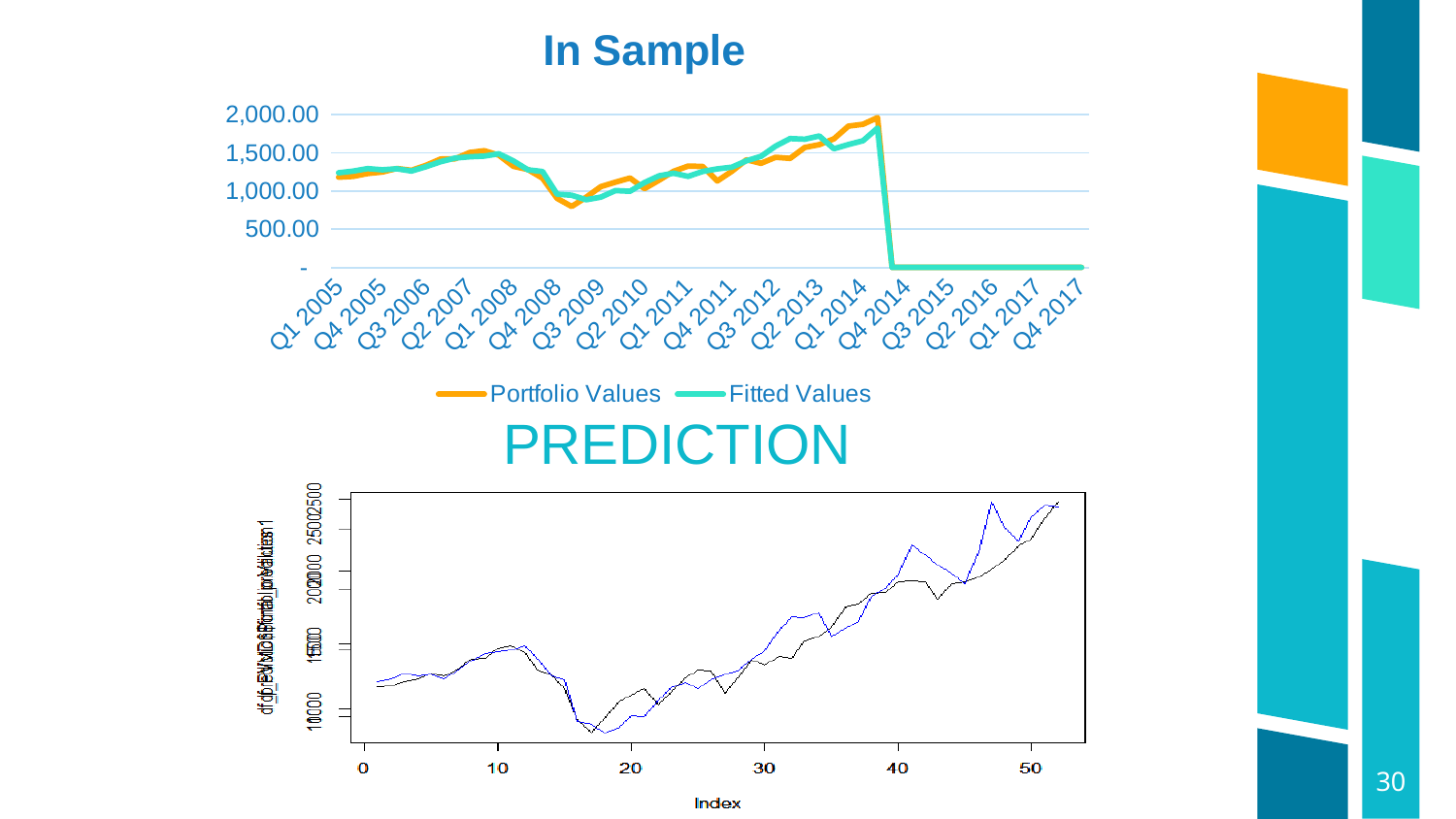
In the 'In Sample' chart, which series is drawn in orange? Portfolio Values How many category labels are shown on the x axis of the 'In Sample' chart? 18 What kind of chart is the 'In Sample' chart? line chart What kind of chart is the 'PREDICTION' chart? line chart In the 'In Sample' chart, is the Fitted Values value at Q3 2015 greater or less than 500.00? less What is the x-axis label of the 'PREDICTION' chart? Index In the 'In Sample' chart, is the Portfolio Values value at Q1 2014 greater or less than 1,500.00? greater In the 'PREDICTION' chart, do the plotted values rise or fall between Index 20 and Index 50? rise In the 'In Sample' chart, is the Portfolio Values value at Q1 2005 greater or less than 1,000.00? greater How many series does the legend of the 'In Sample' chart list? 2 In the 'In Sample' chart, do the Portfolio Values rise or fall between Q3 2009 and Q1 2014? rise